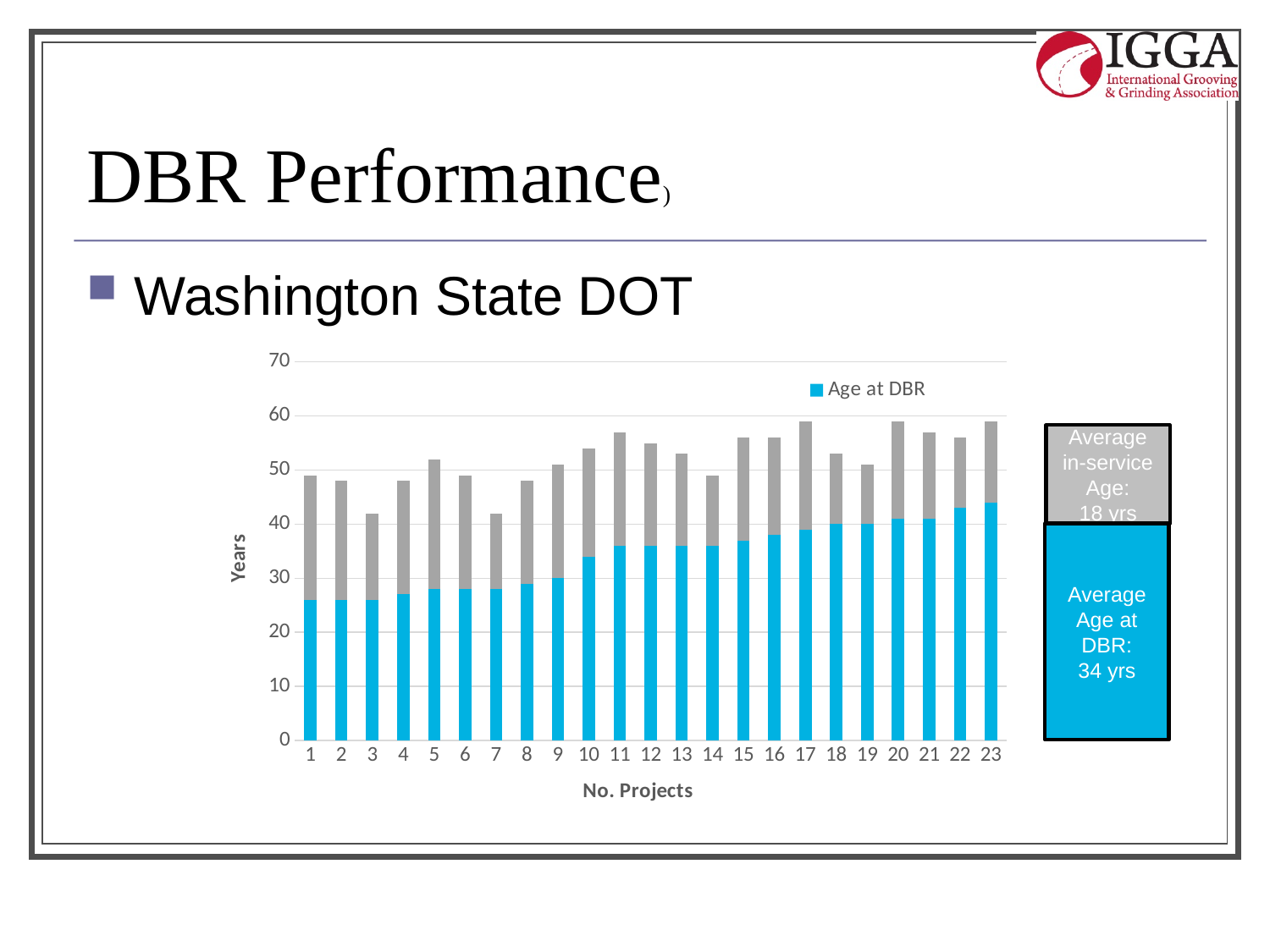
Is the Age at DBR value for project 10 greater or less than 30? greater What is the series name shown in the chart's legend? Age at DBR What is the title of the x axis of the chart? No. Projects Is the Age at DBR value for project 23 greater or less than 40? greater How many series does the chart's legend list? 1 Is the total height of the stacked bar for project 3 greater or less than 50? less How many projects are shown along the x axis of the chart? 23 What kind of chart is shown on the slide? bar chart Do the Age at DBR values generally rise or fall from project 1 to project 23? rise